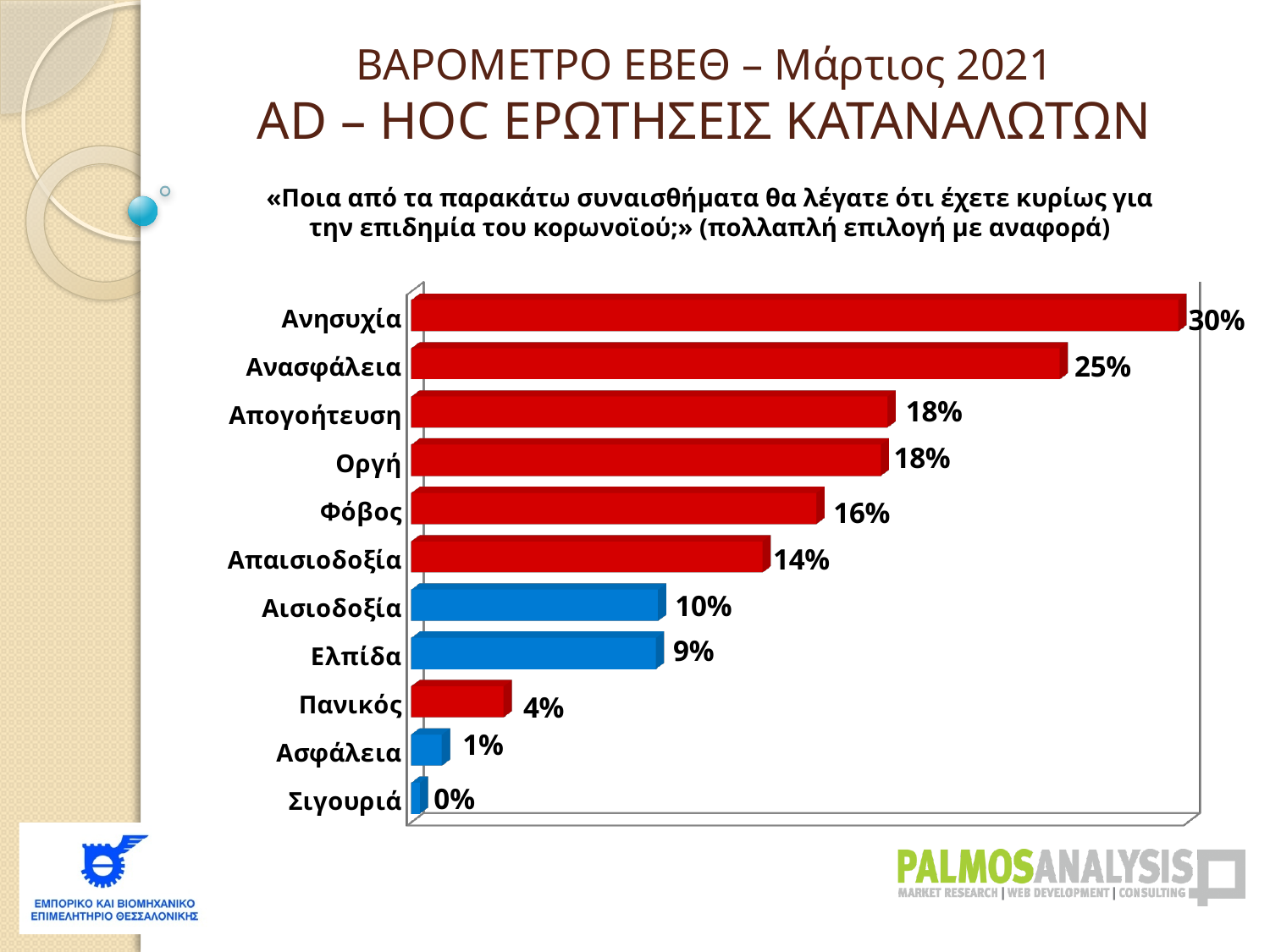
Which is larger, the value for Φόβος or the value for Ελπίδα? Φόβος How many categories are shown in the chart? 11 Which category has the highest value? Ανησυχία What is the difference between the values for Απαισιοδοξία and Αισιοδοξία? 4% Which category has the lowest value? Σιγουριά What is the value for Ελπίδα? 9% Which is larger, the value for Πανικός or the value for Ασφάλεια? Πανικός What kind of chart is shown on the slide? Bar chart What is the difference between the values for Ανησυχία and Ανασφάλεια? 5% What is the value for Φόβος? 16% What colour are the bars for Αισιοδοξία, Ελπίδα, Ασφάλεια and Σιγουριά? Blue What is the value for Ανησυχία? 30%